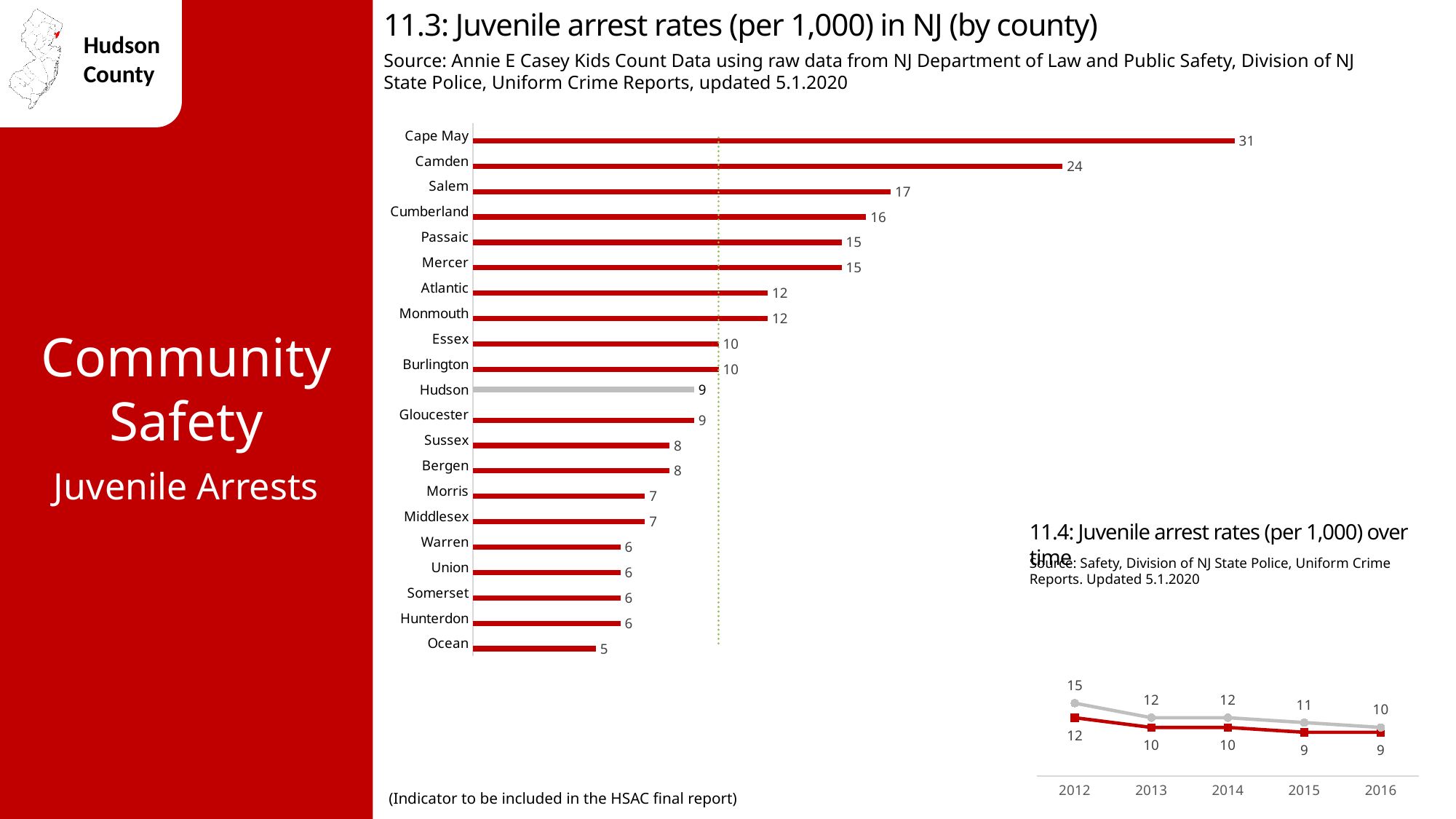
In the chart '11.3: Juvenile arrest rates (per 1,000) in NJ (by county)', which county has the highest juvenile arrest rate? Cape May In the chart '11.3: Juvenile arrest rates (per 1,000) in NJ (by county)', which county's bar is coloured gray instead of red? Hudson In the chart '11.3: Juvenile arrest rates (per 1,000) in NJ (by county)', what is the difference between the values for Cape May and Hudson? 22 In the chart '11.3: Juvenile arrest rates (per 1,000) in NJ (by county)', which county has the lowest juvenile arrest rate? Ocean What kind of chart is '11.3: Juvenile arrest rates (per 1,000) in NJ (by county)'? Bar chart In the chart '11.3: Juvenile arrest rates (per 1,000) in NJ (by county)', which has a higher value, Salem or Passaic? Salem In the chart '11.4: Juvenile arrest rates (per 1,000) over time', what is the value of the red line in 2012? 12 In the chart '11.4: Juvenile arrest rates (per 1,000) over time', what is the value of the gray line in 2016? 10 In the chart '11.3: Juvenile arrest rates (per 1,000) in NJ (by county)', how many counties are shown? 21 In the chart '11.4: Juvenile arrest rates (per 1,000) over time', do the values of the gray line rise or fall from 2012 to 2016? Fall In the chart '11.3: Juvenile arrest rates (per 1,000) in NJ (by county)', what is the value for Camden? 24 In the chart '11.3: Juvenile arrest rates (per 1,000) in NJ (by county)', what is the value for Hudson? 9